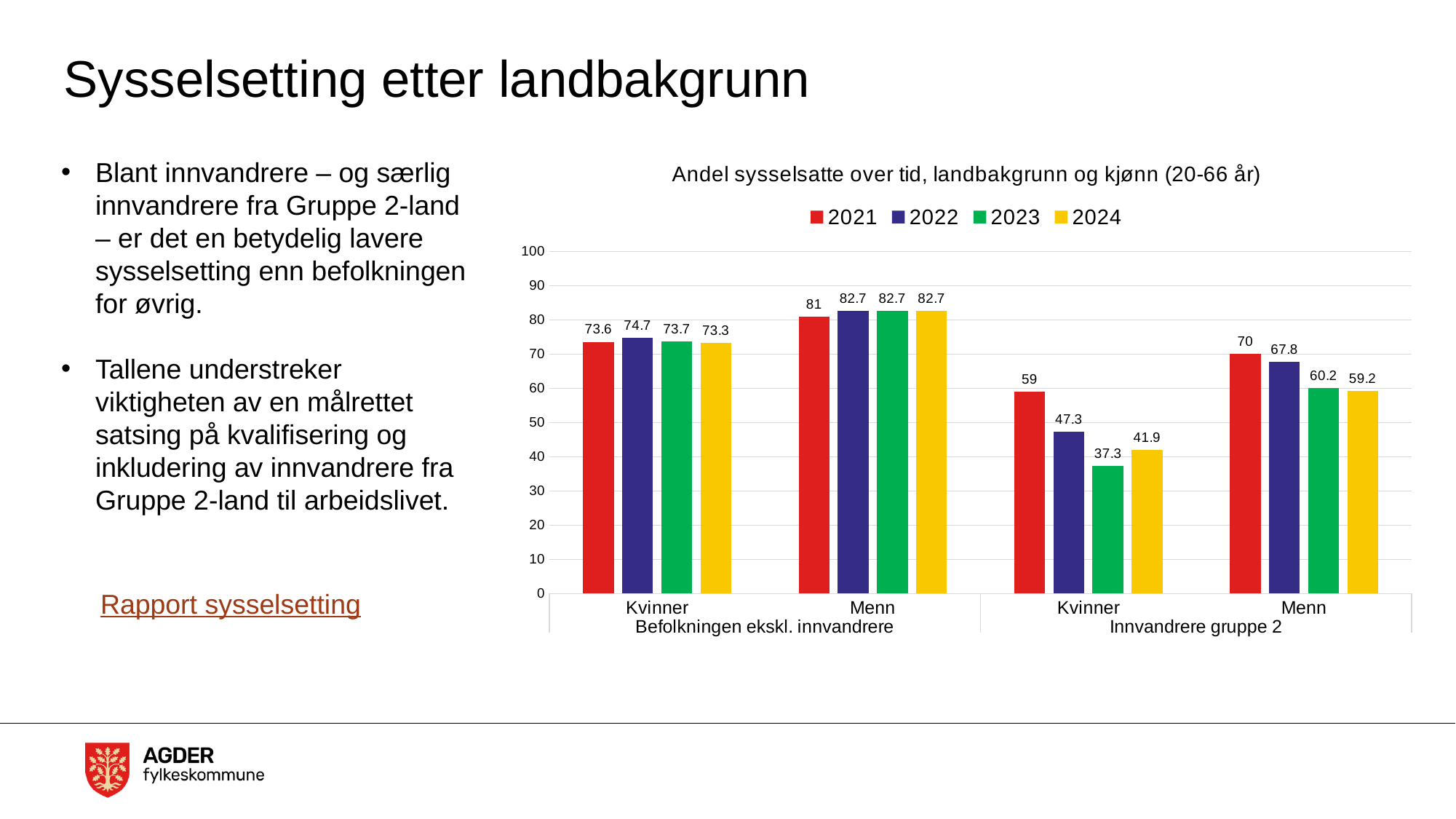
What is the 2021 value for Kvinner in the Befolkningen ekskl. innvandrere group? 73.6 Which year has the lowest value for Menn in the Innvandrere gruppe 2 group? 2024 What kind of chart is shown on the slide? Bar chart What is the difference between the 2021 and 2024 values for Kvinner in the Innvandrere gruppe 2 group? 17.1 Do the values for Kvinner in the Innvandrere gruppe 2 group rise or fall from 2021 to 2023? Fall What is the 2023 value for Kvinner in the Innvandrere gruppe 2 group? 37.3 How many series does the legend list? 4 Which is larger: the 2022 value for Menn in Befolkningen ekskl. innvandrere or the 2022 value for Menn in Innvandrere gruppe 2? Menn in Befolkningen ekskl. innvandrere What is the title of the chart? Andel sysselsatte over tid, landbakgrunn og kjønn (20-66 år) What is the 2024 value for Menn in the Innvandrere gruppe 2 group? 59.2 Which year has the highest value for Kvinner in the Innvandrere gruppe 2 group? 2021 Is the 2022 value for Kvinner in the Innvandrere gruppe 2 group greater or less than 50? less